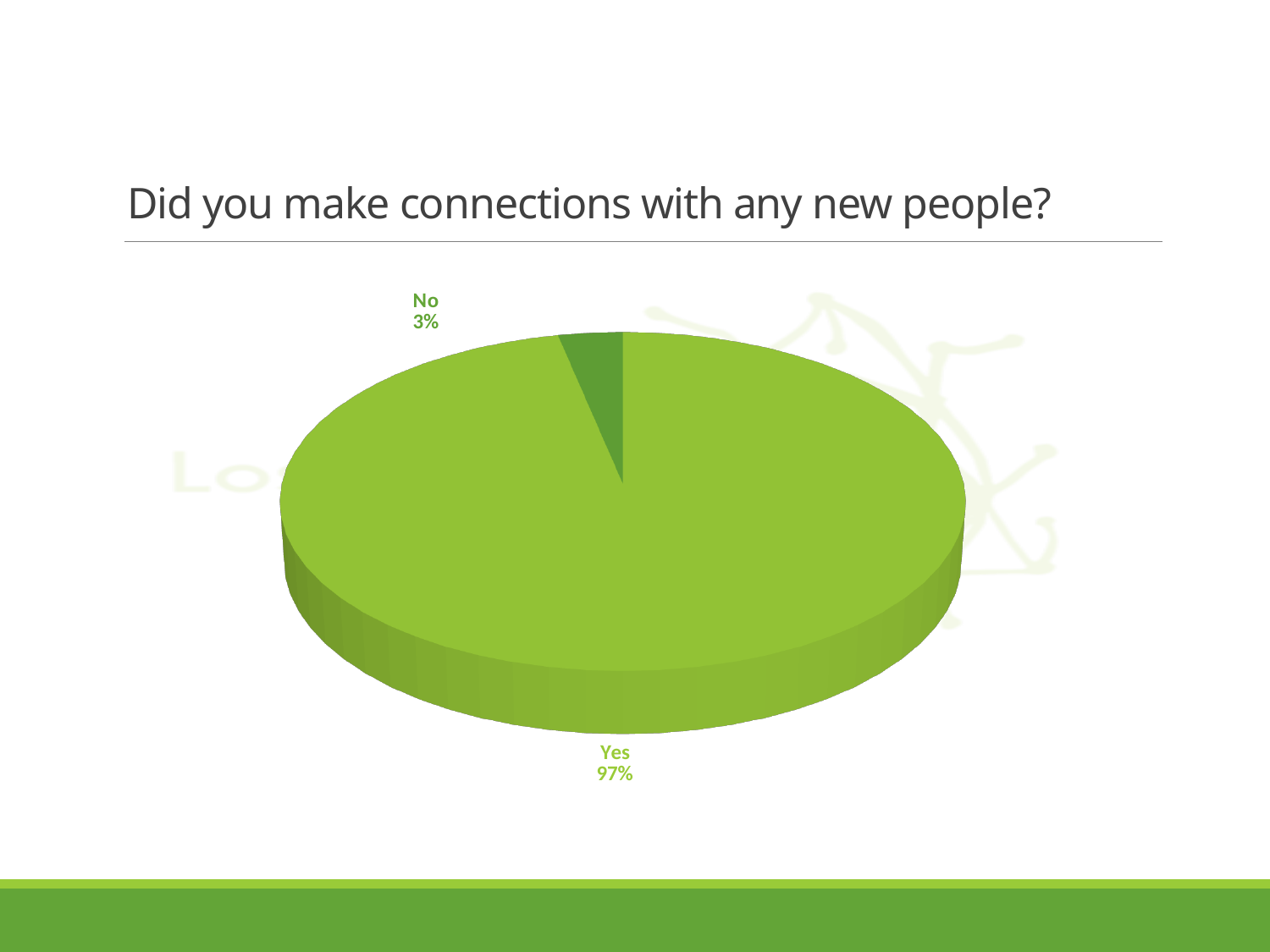
How many slices does the pie chart have? 2 What kind of chart is shown on the slide? Pie chart What percentage of respondents answered Yes? 97% Which is larger, the share for Yes or the share for No? Yes What percentage of respondents answered No? 3% What is the title of the chart on the slide? Did you make connections with any new people? What share of the pie does the No slice represent? 3% Which response has the largest share of the pie? Yes What is the total of the Yes and No shares? 100% Which response has the smallest share of the pie? No What is the difference in percentage points between the Yes and No shares? 94 Is the share for Yes greater or less than 50%? greater